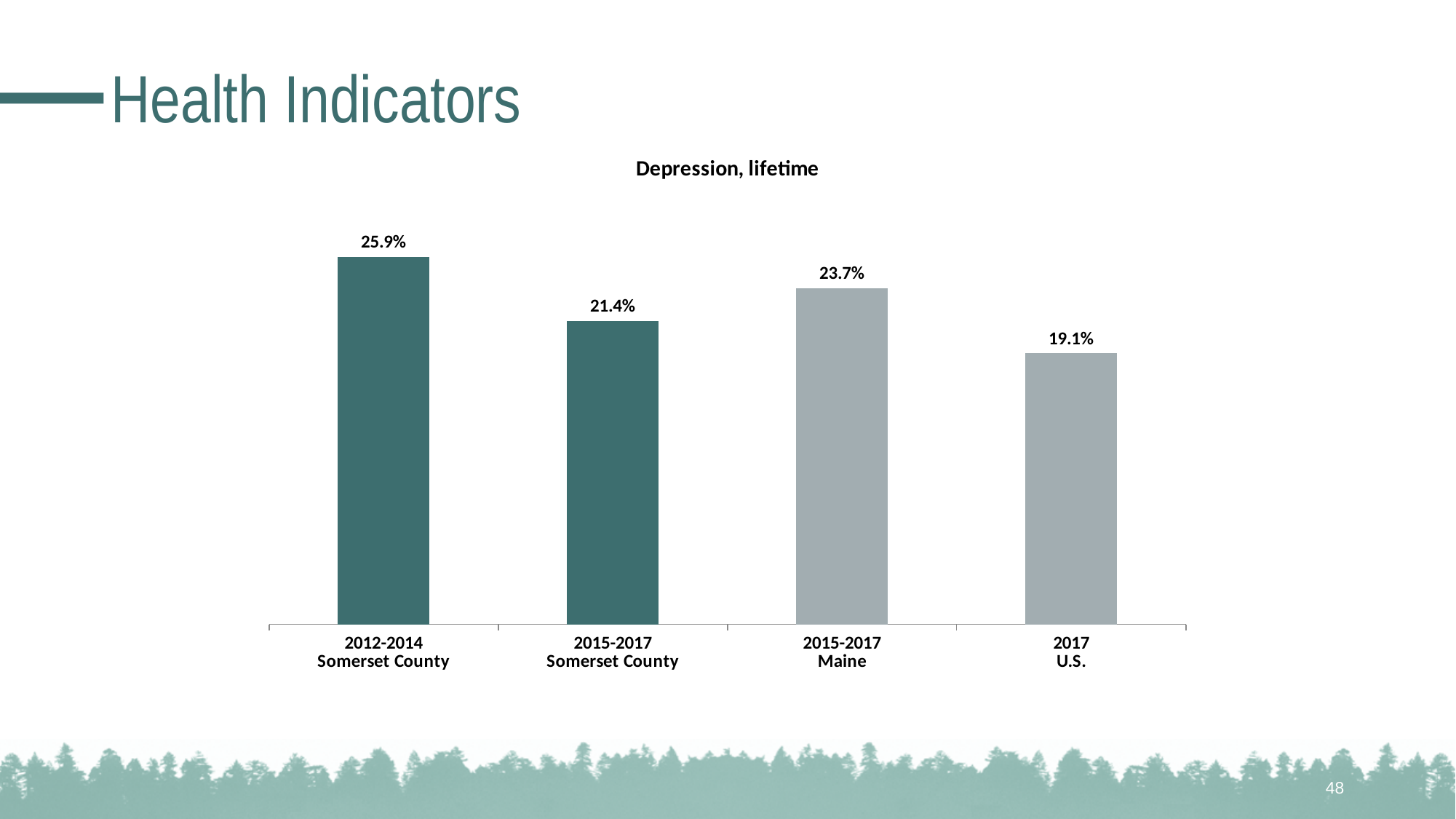
What kind of chart is shown on the slide? Bar chart What is the value for 2012-2014 Somerset County? 25.9% Which is larger, the value for 2015-2017 Somerset County or the value for 2015-2017 Maine? 2015-2017 Maine How many bars are shown in the chart? 4 Which category has the highest value? 2012-2014 Somerset County Which category has the lowest value? 2017 U.S. What is the value for 2017 U.S.? 19.1% What is the value for 2015-2017 Somerset County? 21.4% What is the difference between the 2012-2014 Somerset County value and the 2015-2017 Somerset County value? 4.5% What is the title of the chart? Depression, lifetime What is the value for 2015-2017 Maine? 23.7% What is the difference between the 2015-2017 Maine value and the 2017 U.S. value? 4.6%